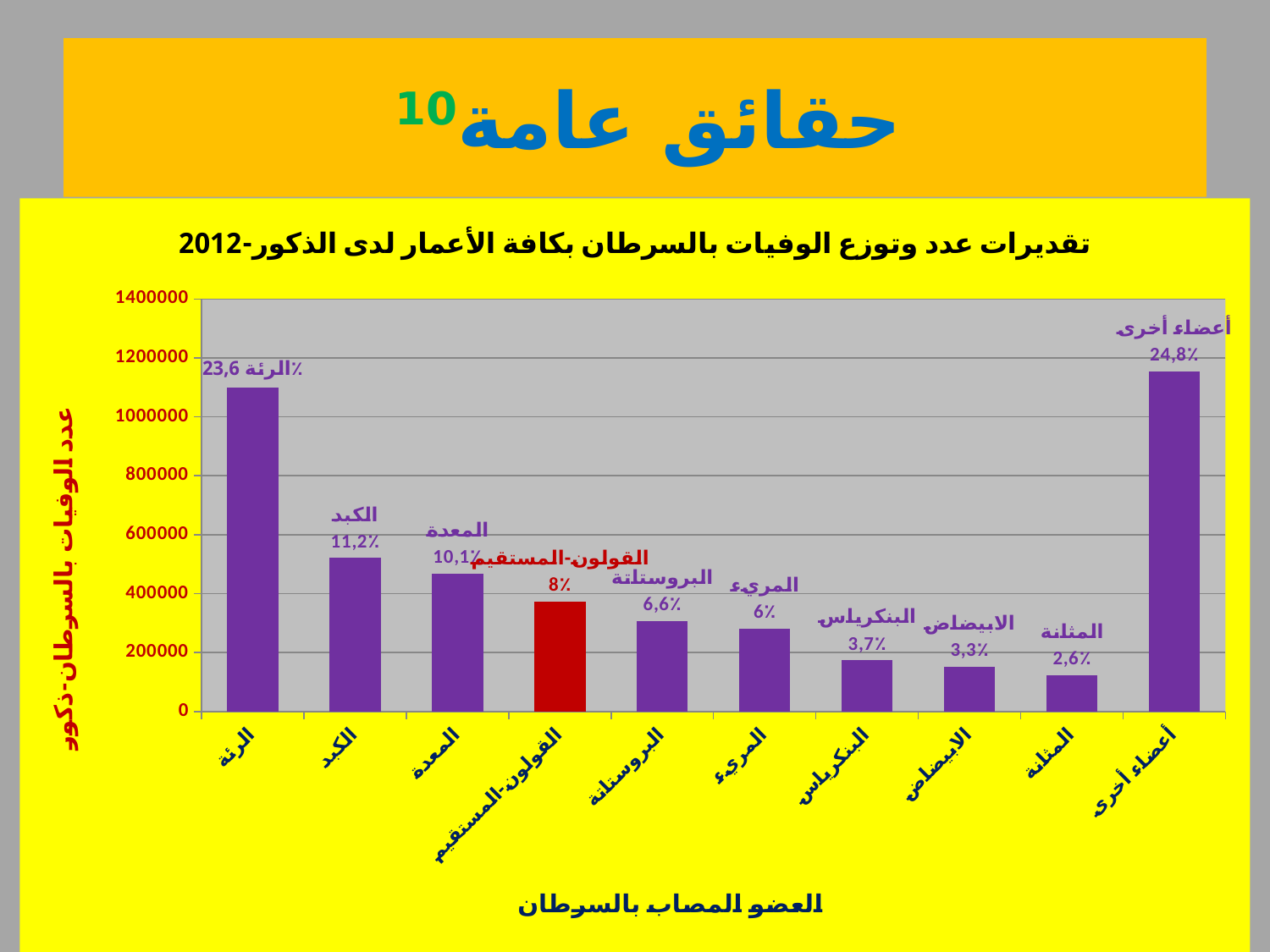
Which category has the lowest percentage label in the chart? المثانة Is the number of deaths for الرئة (lung) greater or less than 1000000? greater What percentage label is shown for الكبد (liver)? 11,2% What percentage label is shown for القولون-المستقيم (colorectal)? 8% What is the difference in percentage points between the labels for الرئة (23,6%) and الكبد (11,2%)? 12,4% What kind of chart is shown on the slide? Bar chart How many categories (organs) are shown on the x axis of the chart? 10 What percentage label is shown for المثانة (bladder)? 2,6% Which category has the highest percentage label in the chart? أعضاء أخرى Which has a larger percentage label, البروستاتة or المريء? البروستاتة What percentage label is shown for الرئة (lung) in the chart? 23,6% Is the number of deaths for الكبد (liver) greater or less than 600000? less